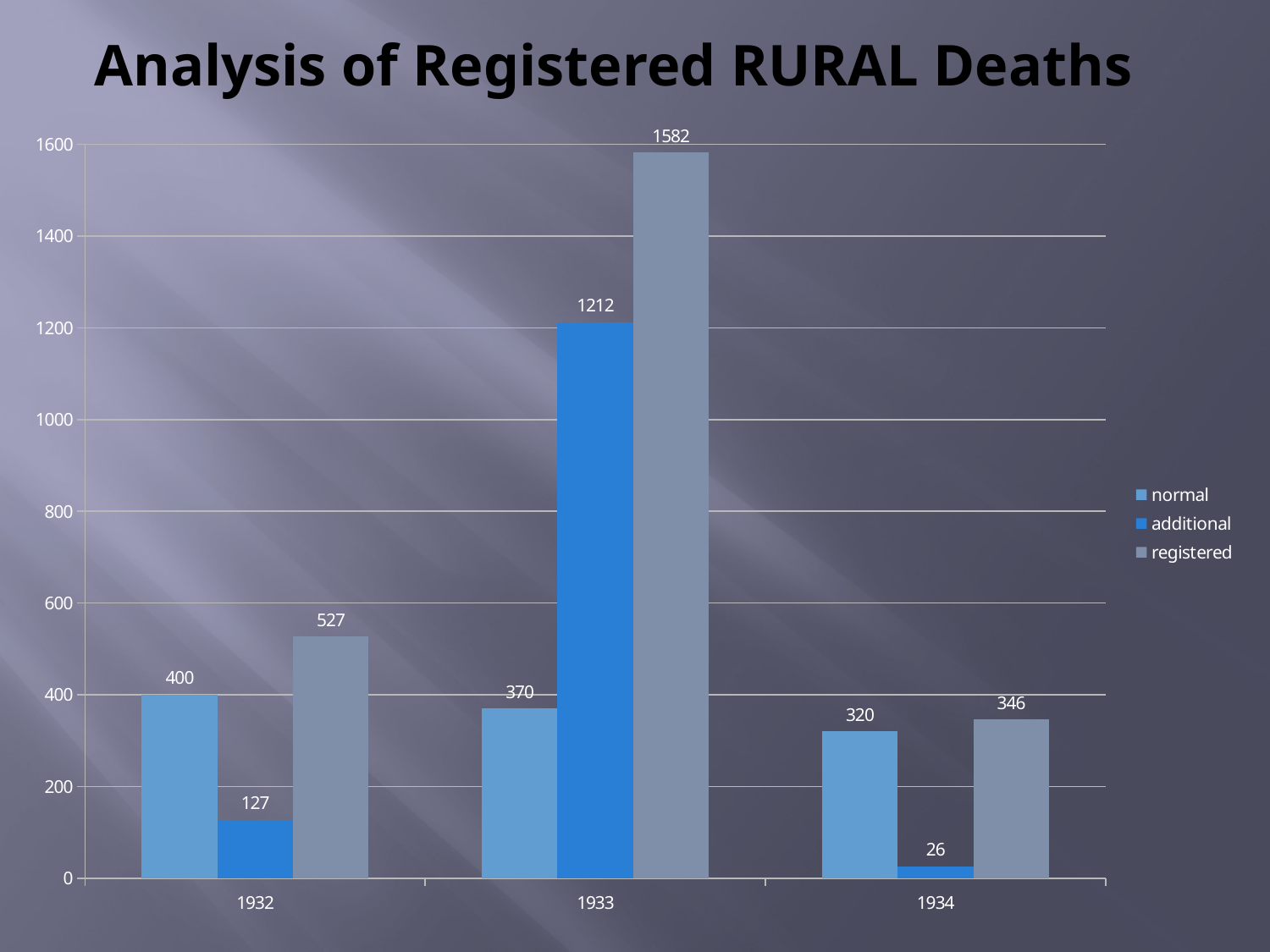
Which is larger, the 'normal' value in 1932 or the 'registered' value in 1934? normal in 1932 How many series does the legend list? 3 What is the difference between the 'additional' values in 1932 and 1934? 101 Which year has the lowest 'additional' value? 1934 What is the value for 'normal' in 1934? 320 Does the 'normal' series rise or fall from 1932 to 1934? fall What is the difference between the 'registered' and 'normal' values in 1933? 1212 Which year has the highest 'registered' value? 1933 What is the value for 'registered' in 1932? 527 How many years are shown on the x axis? 3 What kind of chart is shown on the slide? bar chart What is the value for 'additional' in 1933? 1212